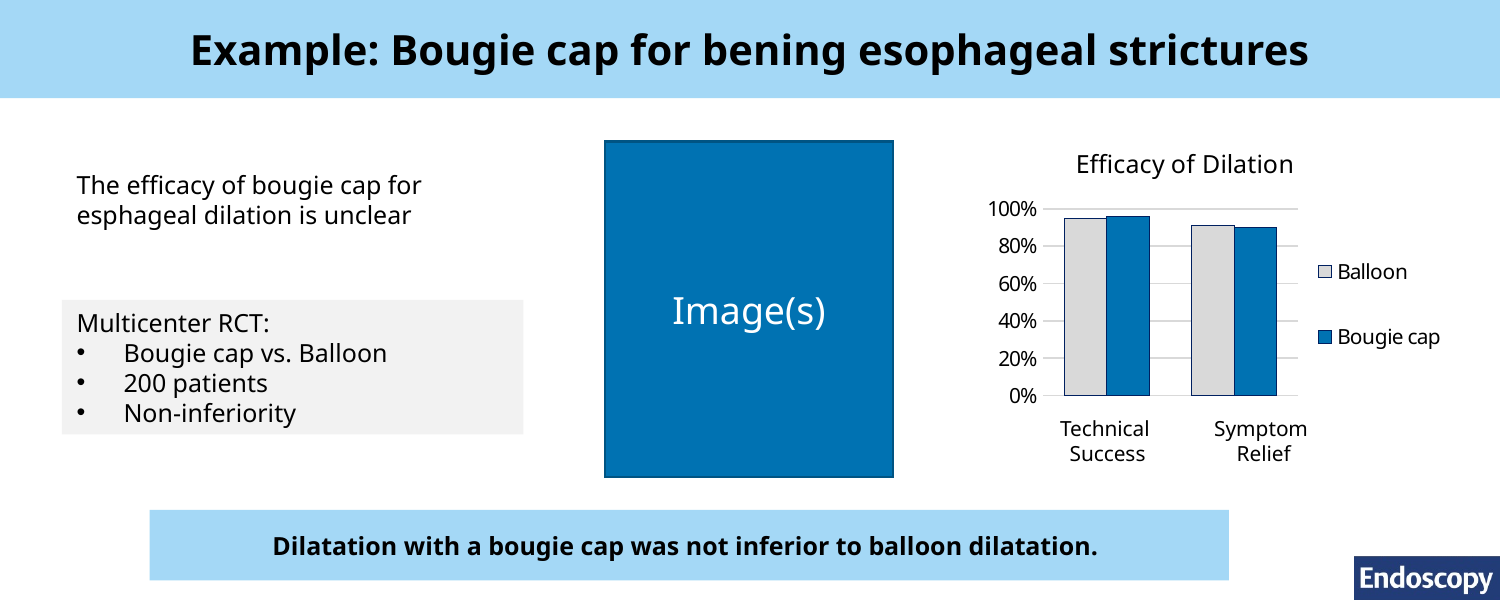
Is the Bougie cap value for Technical Success greater or less than 80%? greater Is the Balloon value for Symptom Relief greater or less than 80%? greater For the Bougie cap series, which category has the higher value: Technical Success or Symptom Relief? Technical Success How many categories are shown on the x axis of the chart? 2 What is the highest value shown on the y axis of the chart? 100% Which series are listed in the chart legend? Balloon and Bougie cap What kind of chart is shown on the slide? bar chart How many series does the chart legend list? 2 Is the Balloon value for Technical Success greater or less than 80%? greater What is the title of the chart? Efficacy of Dilation